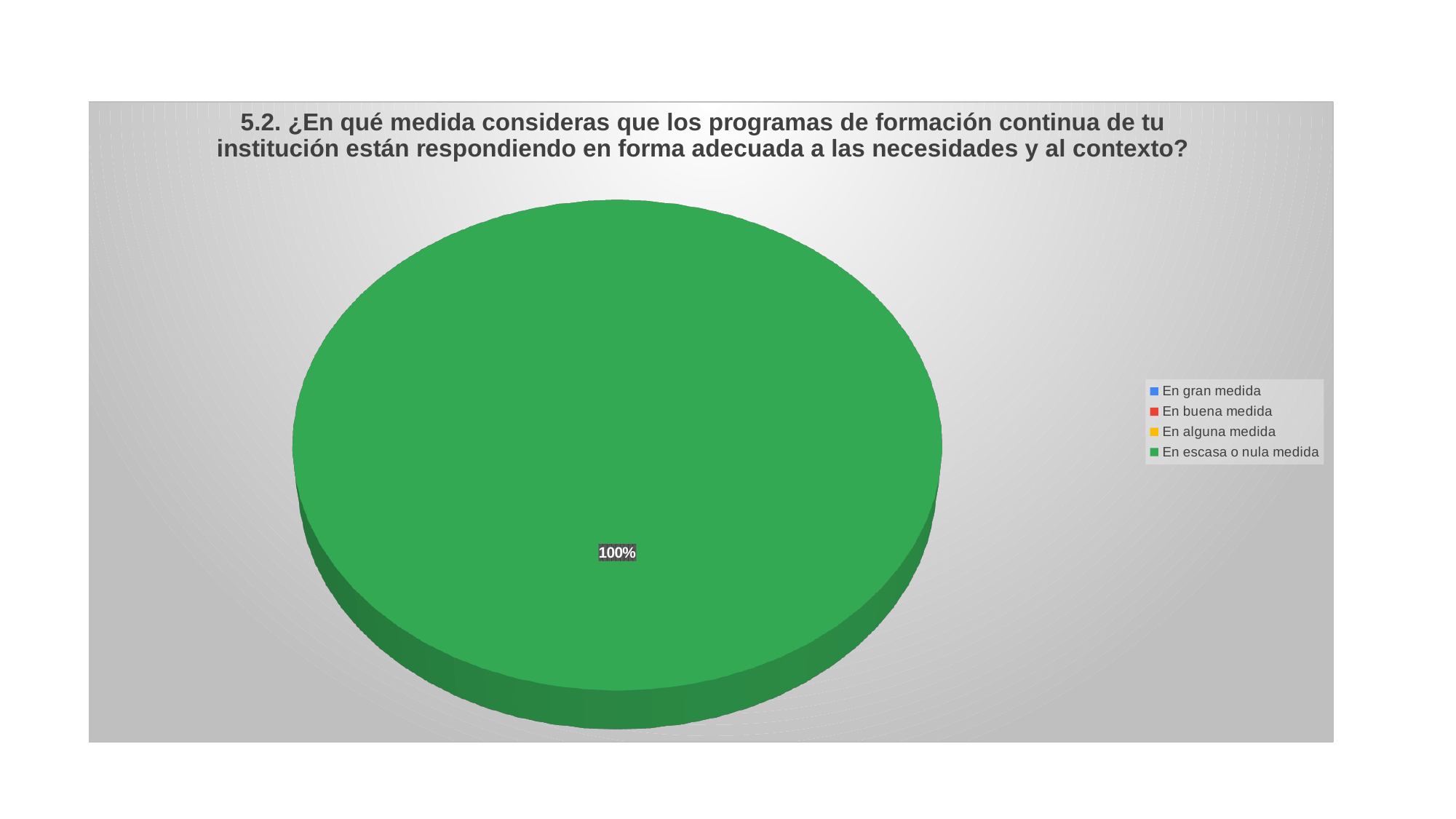
What share of the pie does "En escasa o nula medida" have? 100% Which category has the largest share of the pie? En escasa o nula medida Which legend entry is shown in blue? En gran medida What is the data label printed on the pie? 100% How many entries does the legend list? 4 How many slices are visible in the pie? 1 Which legend entry is shown in green? En escasa o nula medida Is the share for "En escasa o nula medida" greater or less than 50%? greater What kind of chart is shown on the slide? Pie chart